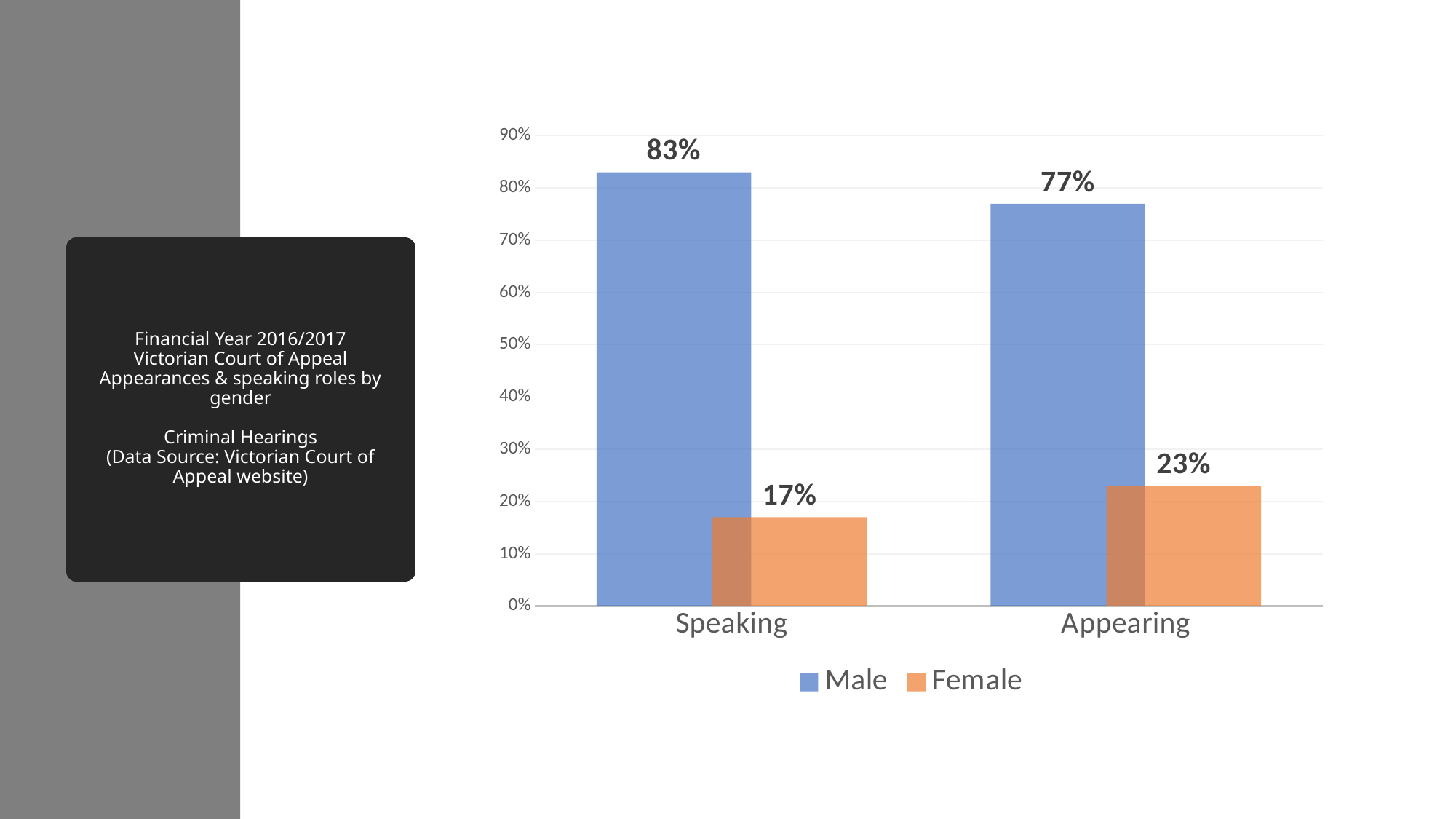
What is the Male value for Speaking? 83% Which category has the highest Male value? Speaking How many series does the legend list? 2 How many categories are shown on the x axis? 2 What kind of chart is shown on the slide? Bar chart What is the difference between the Female values for Appearing and Speaking? 6% What is the difference between the Male and Female values for Speaking? 66% What is the Female value for Speaking? 17% Which is larger, the Female value for Speaking or the Female value for Appearing? Appearing What is the Male value for Appearing? 77% What is the Female value for Appearing? 23% Which category has the lowest Female value? Speaking